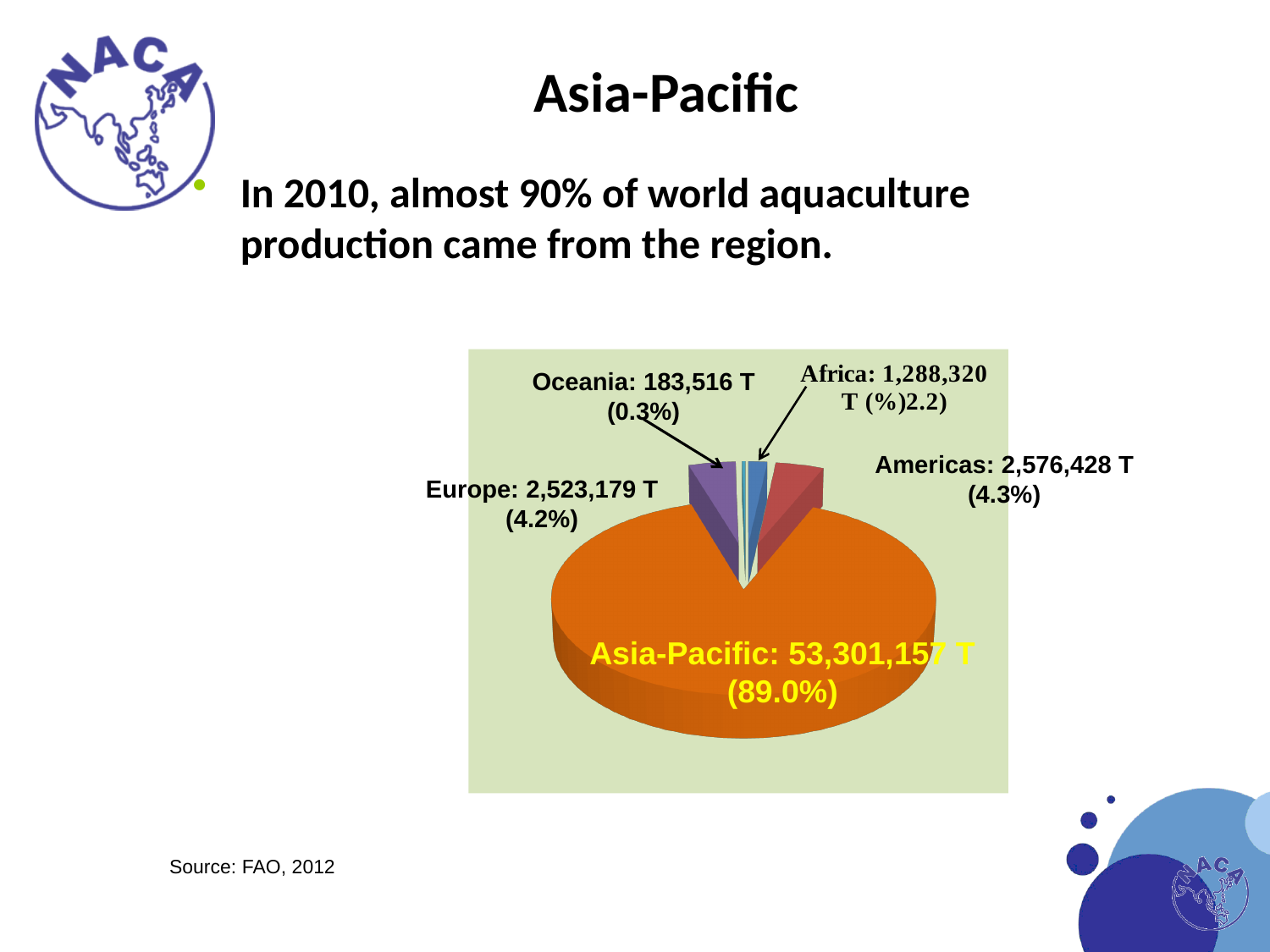
What is the difference in production between the Americas and Europe? 53,249 T Which has the larger production value, the Americas or Europe? Americas What is the production value shown for Europe? 2,523,179 T What is the production value shown for Asia-Pacific? 53,301,157 T What is the production value shown for Africa? 1,288,320 T How many regions (slices) does the pie chart show? 5 Which region has the smallest slice of the pie? Oceania What share of the pie does the Americas slice represent? 4.3% What is the production value shown for Oceania? 183,516 T Which region has the largest slice of the pie? Asia-Pacific What source is cited for the chart data? FAO, 2012 What kind of chart is shown on the slide? pie chart